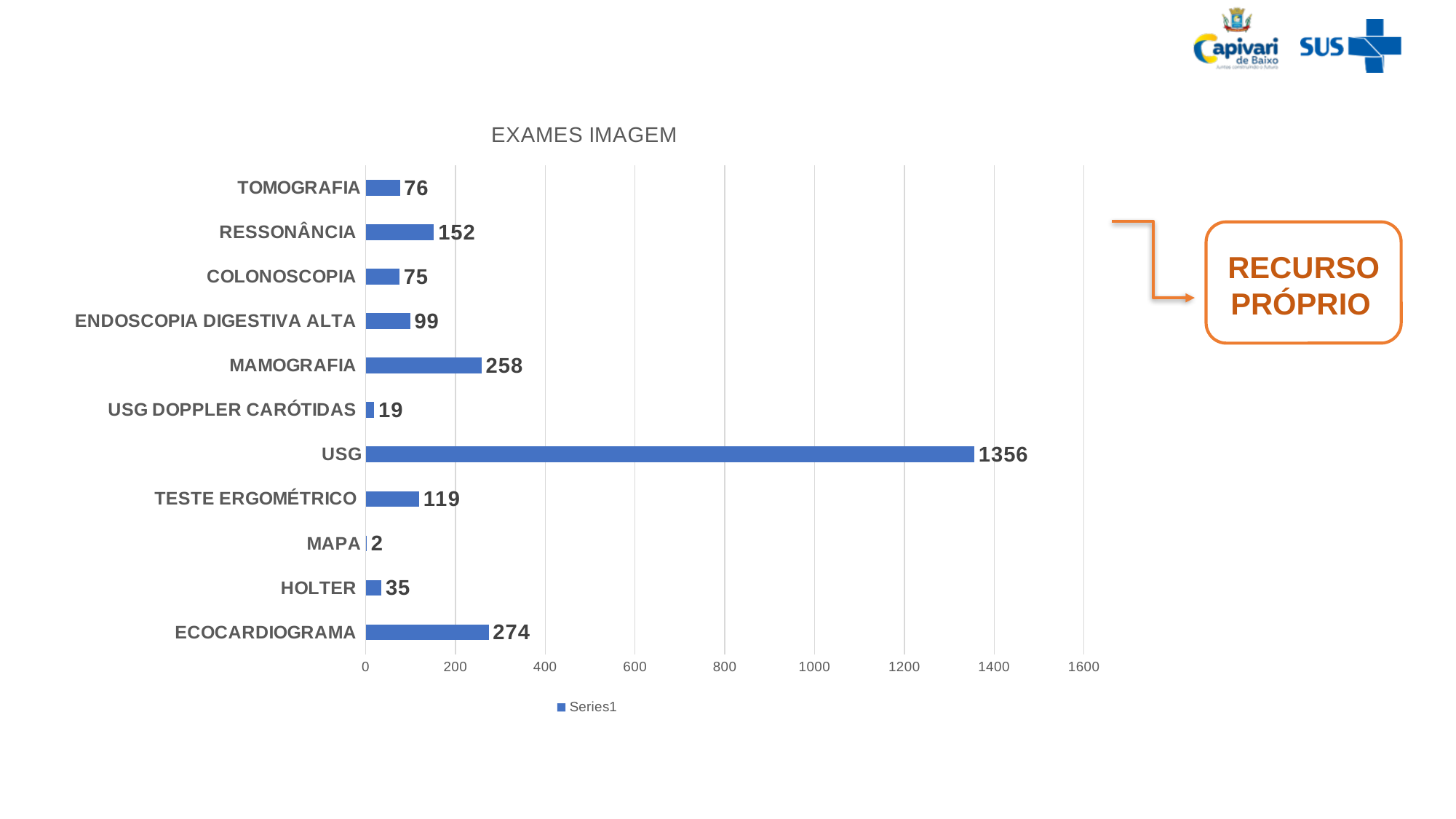
Which category has the lowest value? MAPA What is the difference between the values for RESSONÂNCIA and TOMOGRAFIA? 76 What is the value for MAMOGRAFIA? 258 What kind of chart is shown on the slide? bar chart What is the value for ENDOSCOPIA DIGESTIVA ALTA? 99 Which is larger, the value for TESTE ERGOMÉTRICO or the value for HOLTER? TESTE ERGOMÉTRICO Is the value for USG greater or less than 1200? greater What is the value for USG? 1356 Which category has the highest value? USG How many categories are shown in the chart? 11 What is the difference between the values for ECOCARDIOGRAMA and MAMOGRAFIA? 16 What is the title of the chart? EXAMES IMAGEM